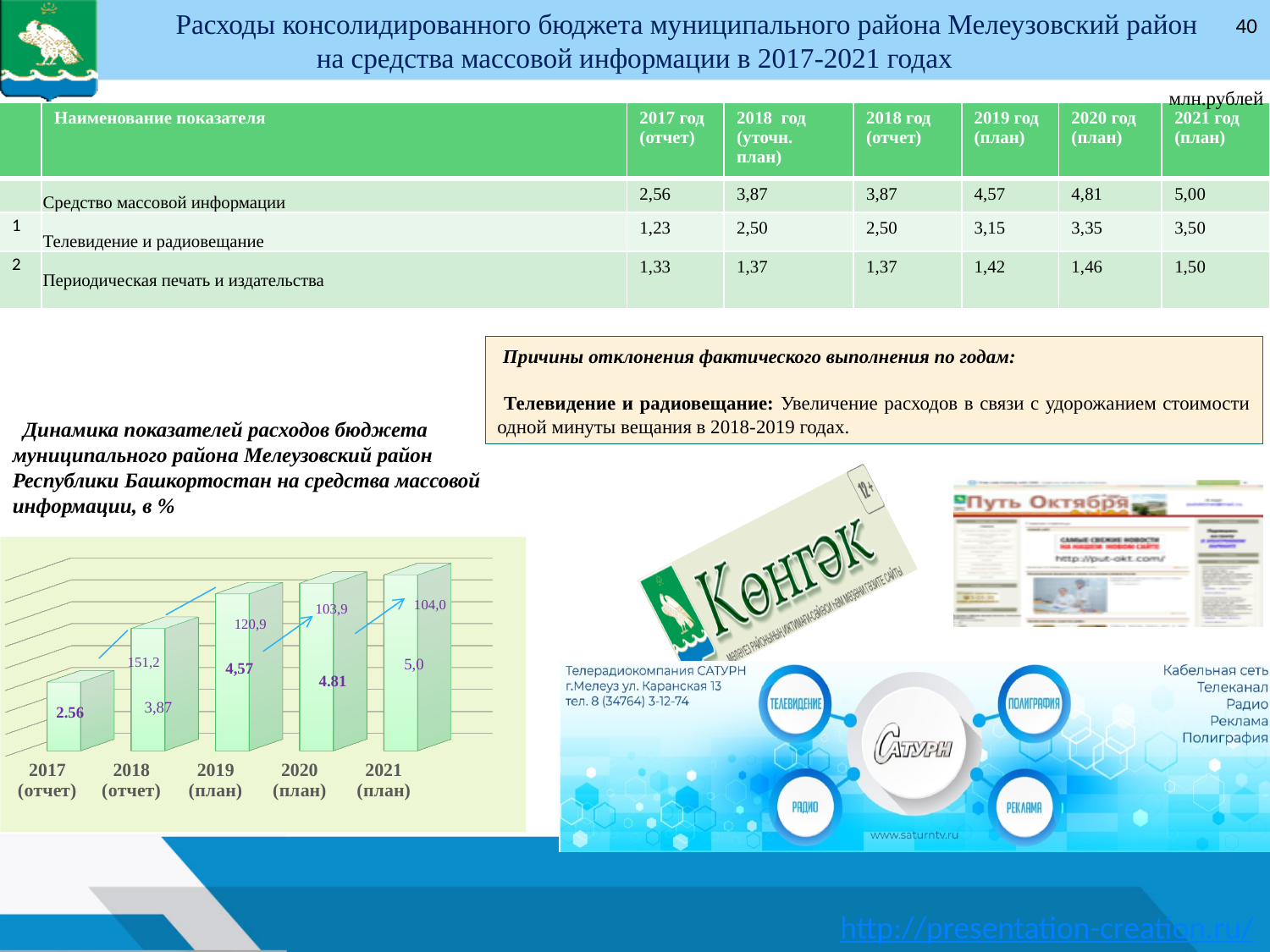
What is the value for 2018 (отчет) in the chart? 3,87 How many bars (years) does the chart show? 5 What growth percentage is printed above the 2018 (отчет) bar? 151,2 What kind of chart is shown on the slide? bar chart What is the value for 2019 (план) in the chart? 4,57 Which is larger in the chart: the value for 2019 (план) or 2018 (отчет)? 2019 (план) What is the value for 2021 (план) in the chart? 5,0 What is the value for 2017 (отчет) in the chart? 2.56 What is the difference between the values for 2021 (план) and 2019 (план)? 0,43 Which year has the highest value in the chart? 2021 (план) Do the values in the chart rise or fall from 2017 to 2021? rise Which year has the lowest value in the chart? 2017 (отчет)